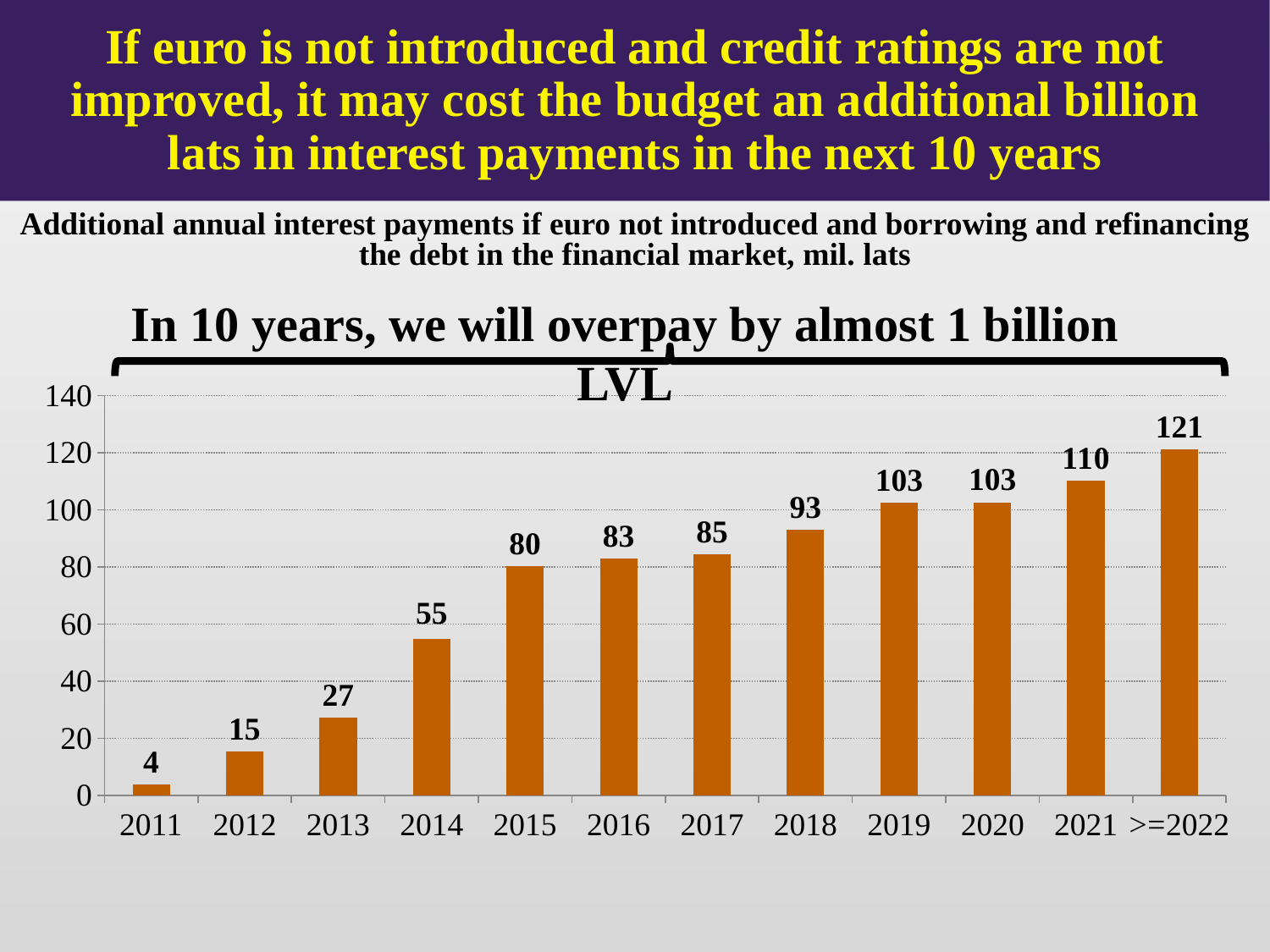
What is the chart's title? In 10 years, we will overpay by almost 1 billion LVL What is the value for 2014? 55 What kind of chart is this? bar chart How many categories are shown on the x axis? 12 Which category has the highest value? >=2022 What is the value for 2011? 4 Which is larger, the value for 2016 or the value for 2013? 2016 What is the value for 2018? 93 What is the difference between the values for 2021 and 2015? 30 Which category has the lowest value? 2011 Is the value for 2017 greater or less than 100? less Do the values generally rise or fall from 2011 to >=2022? rise